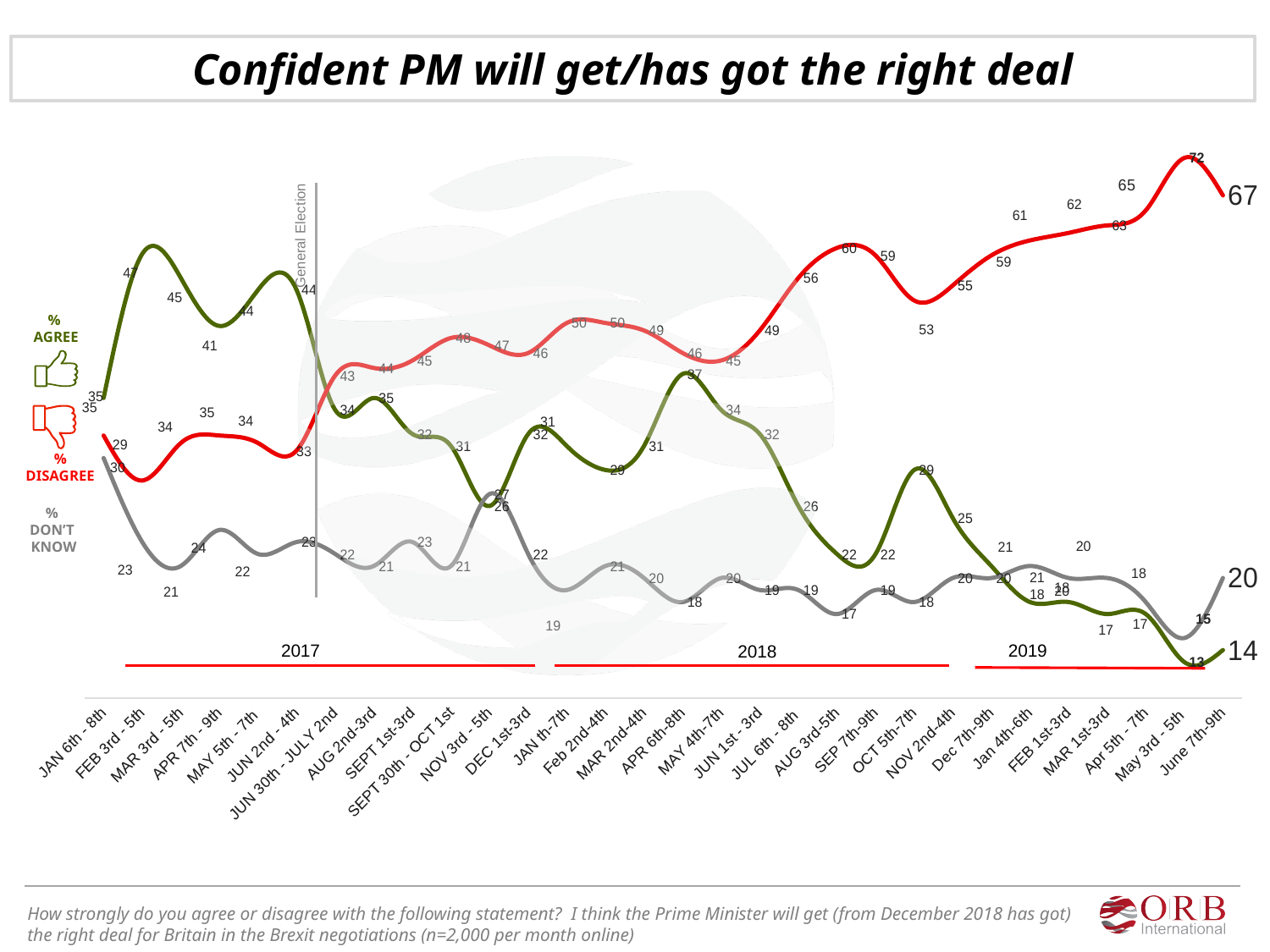
At June 7th-9th 2019, which is larger: % Agree or % Don't Know? % Don't Know How many series are plotted on the chart? 3 Does the % Disagree line generally rise or fall from 2017 to 2019? rise What kind of chart is shown on the slide? line chart What is the difference between % Disagree and % Agree at June 7th-9th 2019? 53 What is the highest value reached by the % Disagree line? 72 What is the % Agree value at the first point, JAN 6th-8th 2017? 35 What is the % Disagree value at the first point, JAN 6th-8th 2017? 35 What is the % Disagree value at June 7th-9th 2019, the last point on the chart? 67 What is the % Don't Know value at June 7th-9th 2019, the last point on the chart? 20 What is the % Agree value at June 7th-9th 2019, the last point on the chart? 14 What event does the vertical grey line on the chart mark? General Election